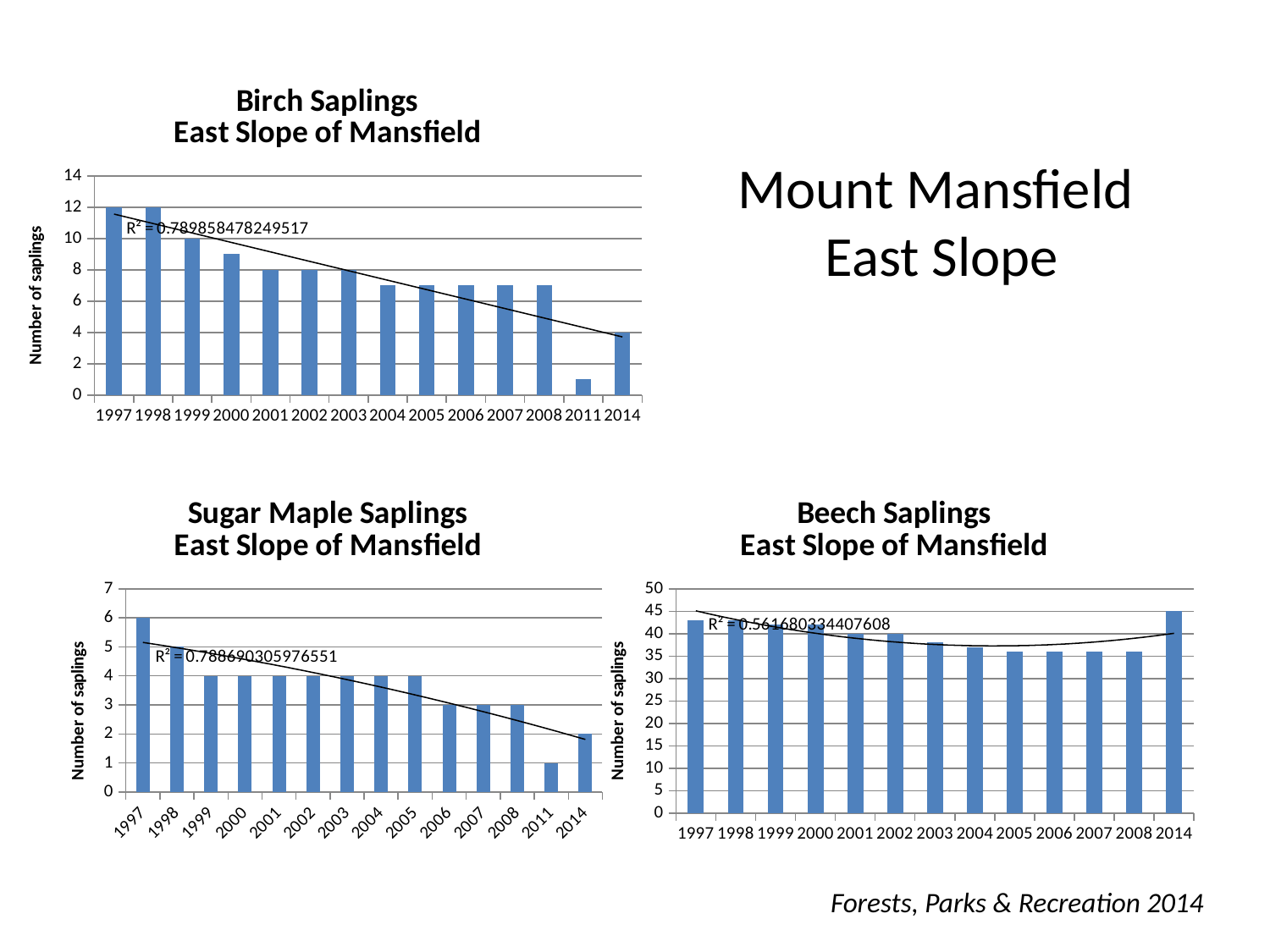
In the Beech Saplings chart, is the value for 2005 greater or less than 40? less In the Birch Saplings chart, how many years are shown on the x axis? 14 What kind of chart is the Birch Saplings chart? bar chart In the Sugar Maple Saplings chart, what is the difference between the values for 1997 and 2011? 5 In the Birch Saplings chart, which year has the lowest number of saplings? 2011 In the Birch Saplings chart, is the value for 2000 greater or less than 10? less In the Sugar Maple Saplings chart, which is larger, the value for 2006 or the value for 2014? 2006 In the Beech Saplings chart, which year has the highest number of saplings? 2014 In the Beech Saplings chart, what is the number of saplings for 2014? 45 In the Sugar Maple Saplings chart, what is the number of saplings for 1997? 6 In the Birch Saplings chart, do the values generally rise or fall from 1997 to 2008? fall In the Birch Saplings chart, what is the number of saplings for 1999? 10